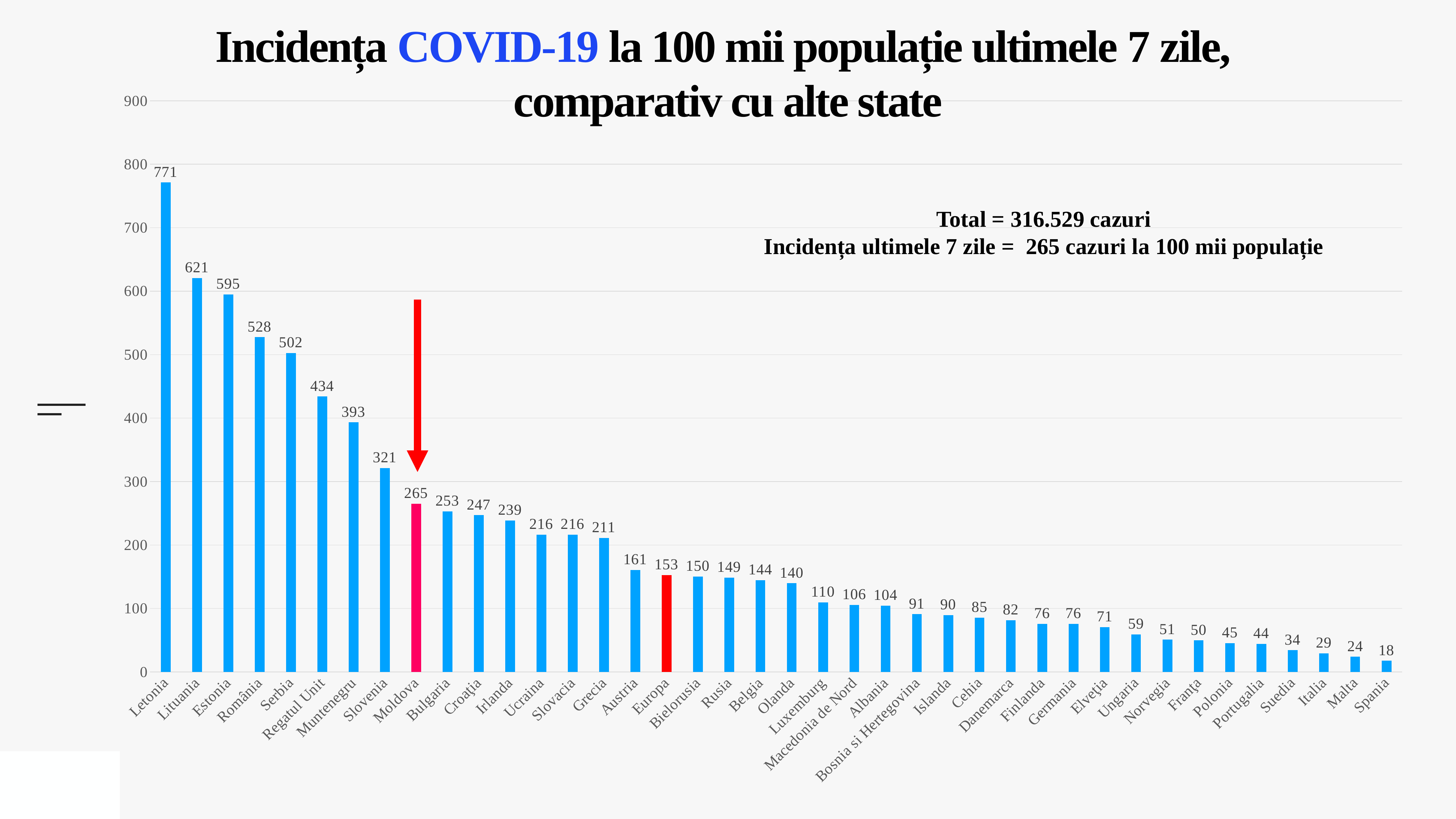
What is the value for Europa? 153 What kind of chart is shown on the slide? bar chart What colour is the bar for Moldova? pink/magenta Which country has the highest value? Letonia Do the values rise or fall from left to right along the x axis? fall Which country has the lowest value? Spania What is the value for Regatul Unit? 434 How many countries or regions are shown on the x axis? 40 What is the difference between the values for Letonia and Lituania? 150 What is the value for Moldova? 265 Which is larger, the value for Serbia or the value for Muntenegru? Serbia What is the difference between the values for Moldova and Europa? 112